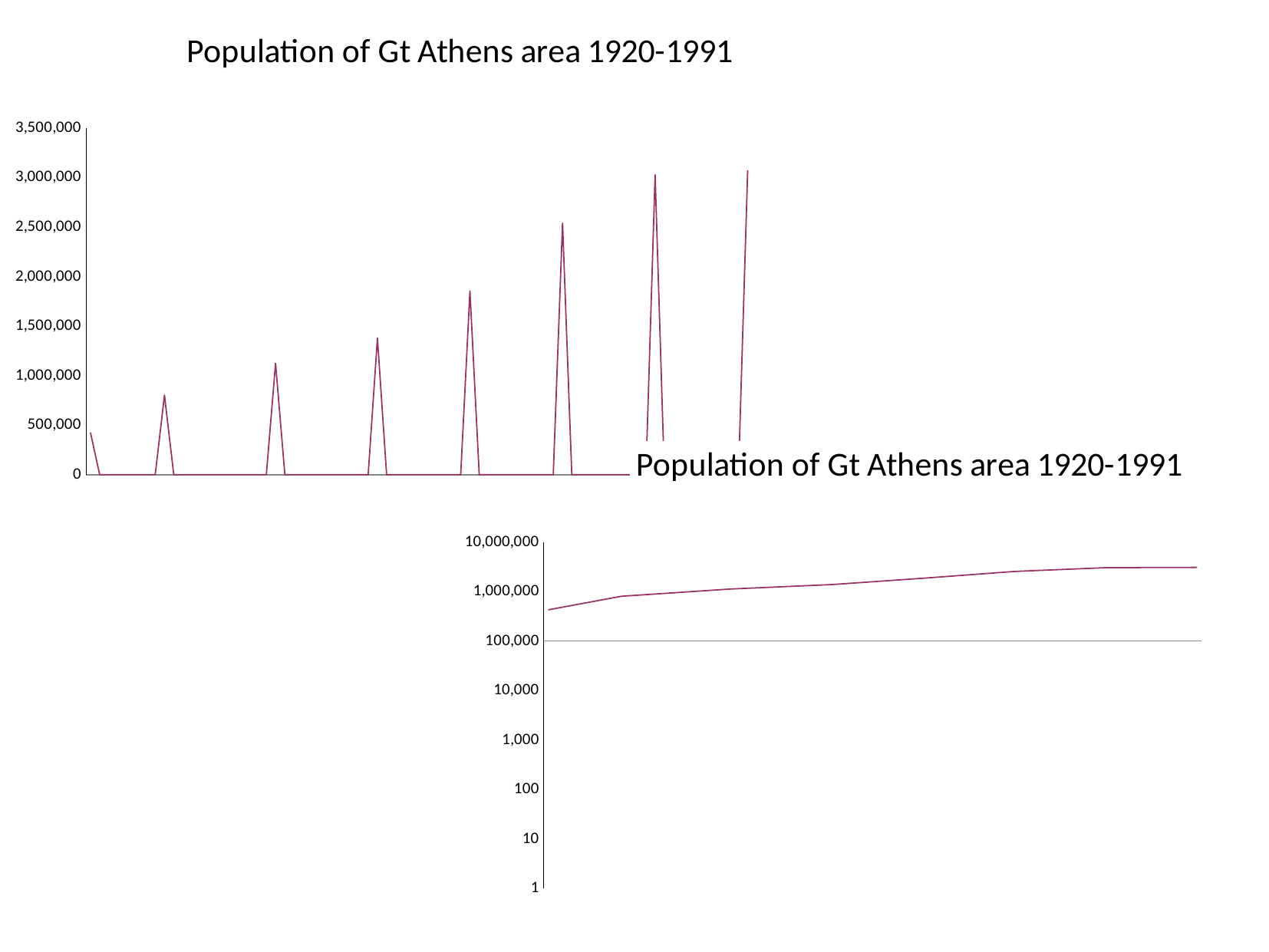
In the top-left chart, is the peak at the far right higher or lower than the peak at the far left? higher What is the title of the top-left chart? Population of Gt Athens area 1920-1991 In the top-left chart, is the highest peak greater or less than 2,500,000? greater In the bottom-right chart, is the value at the far left of the line greater or less than 100,000? greater In the bottom-right chart, is the value at the far right of the line greater or less than 1,000,000? greater What kind of chart is the top-left chart on the slide? line chart What is the highest value shown on the y axis of the top-left chart? 3,500,000 In the bottom-right chart, does the line rise or fall from left to right? rise What kind of chart is the bottom-right chart on the slide? line chart